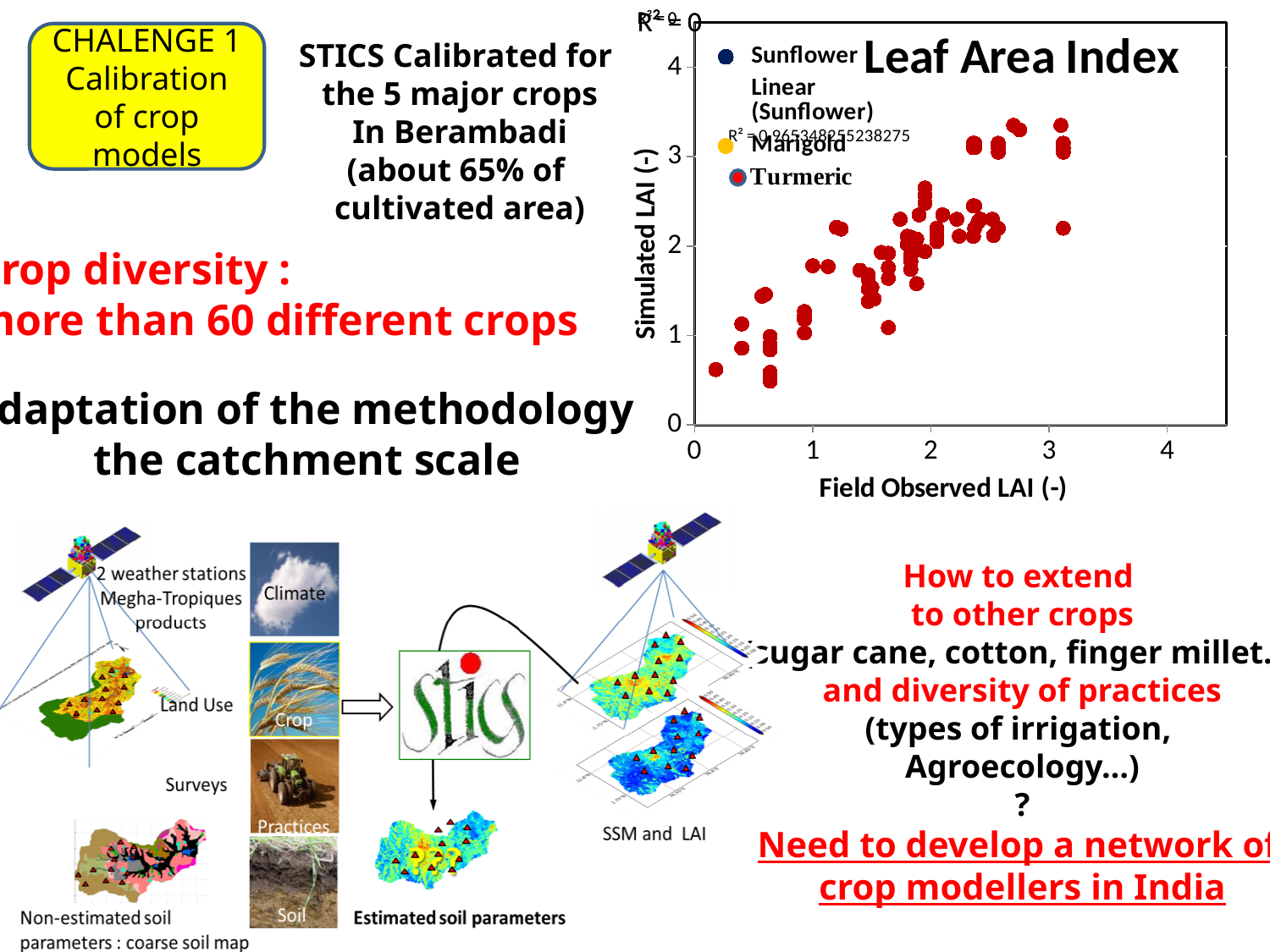
What kind of chart is the Leaf Area Index chart? scatter chart In the Leaf Area Index chart, do the simulated LAI values generally rise or fall as field observed LAI increases? rise In the Leaf Area Index chart, is the highest simulated LAI value greater or less than 4? less What is the highest tick value shown on the y axis of the Leaf Area Index chart? 4 What is the title of the chart on the slide? Leaf Area Index In the Leaf Area Index chart, is the lowest simulated LAI value greater or less than 1? less What is the x-axis title of the Leaf Area Index chart? Field Observed LAI (-) How many entries does the legend of the Leaf Area Index chart list? 4 In the Leaf Area Index chart, is the largest field observed LAI value greater or less than 3? greater